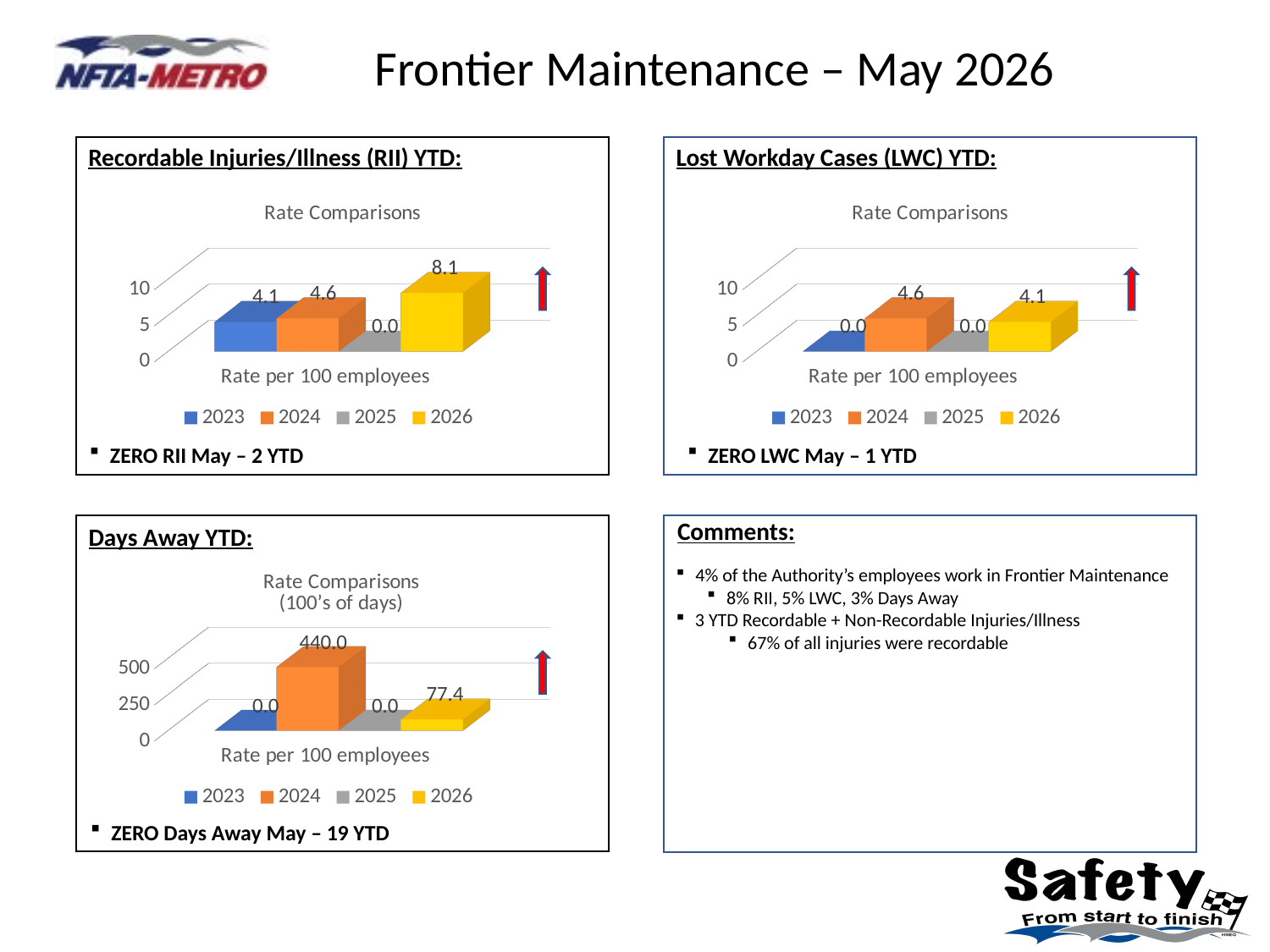
What is the title of the chart in the Lost Workday Cases (LWC) YTD box? Rate Comparisons What kind of chart is the Recordable Injuries/Illness (RII) YTD chart? Bar chart In the Days Away YTD chart, what is the value for 2024? 440.0 In the Days Away YTD chart, what is the value for 2026? 77.4 In the Lost Workday Cases (LWC) YTD chart, what is the value for 2025? 0.0 How many series does the legend list in the Days Away YTD chart? 4 In the Recordable Injuries/Illness (RII) YTD chart, what is the value for 2026? 8.1 In the Recordable Injuries/Illness (RII) YTD chart, which year has the highest rate? 2026 In the Recordable Injuries/Illness (RII) YTD chart, what is the difference between the 2026 and 2024 values? 3.5 In the Lost Workday Cases (LWC) YTD chart, what is the value for 2024? 4.6 In the Lost Workday Cases (LWC) YTD chart, which is larger, the 2024 value or the 2026 value? 2024 In the Days Away YTD chart, what is the difference between the 2024 and 2026 values? 362.6